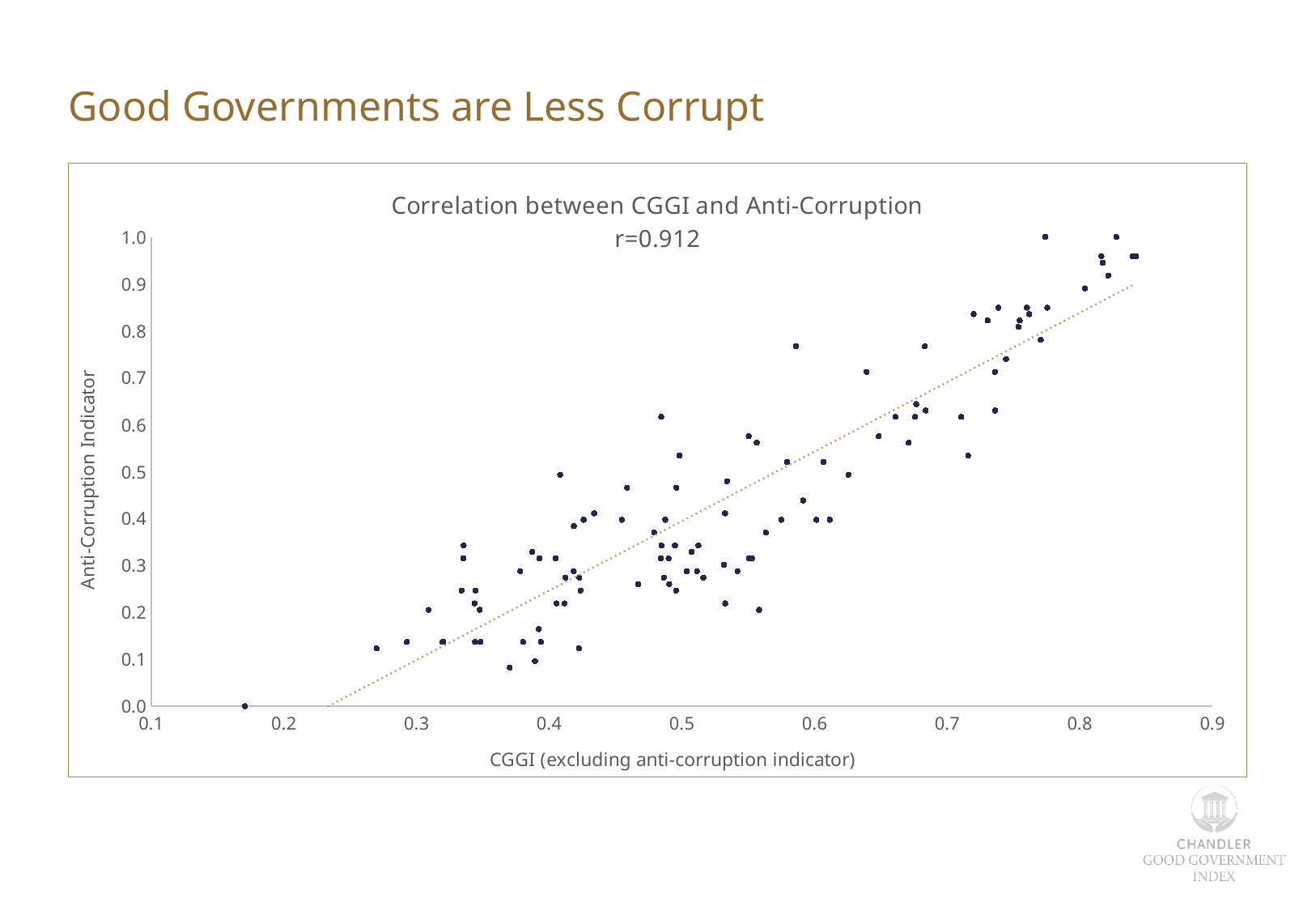
Is the CGGI value of the lowest plotted point greater or less than 0.2? less What is the correlation coefficient (r) shown in the chart title? r=0.912 What is the title of the chart? Correlation between CGGI and Anti-Corruption What is the highest Anti-Corruption Indicator value plotted on the chart? 1.0 What kind of chart is shown on the slide? scatter plot Is the Anti-Corruption Indicator of the point with the highest CGGI value greater or less than 0.9? greater As CGGI increases along the x axis, does the Anti-Corruption Indicator generally rise or fall? rise What is the lowest Anti-Corruption Indicator value plotted on the chart? 0.0